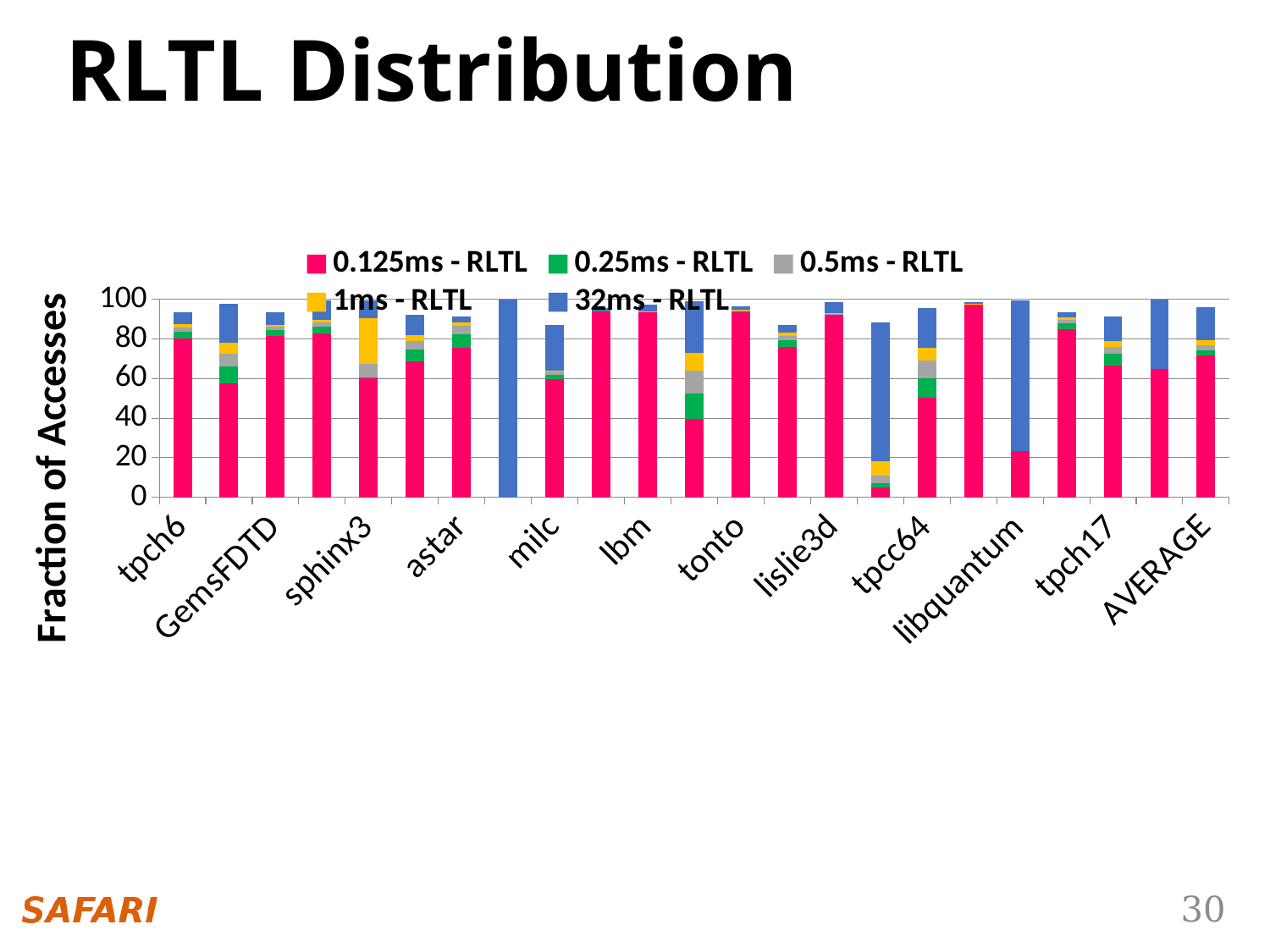
Is the 0.125ms - RLTL value for lbm greater or less than 80? greater Is the 0.125ms - RLTL value for AVERAGE greater or less than 60? greater Among the labelled categories on the x axis, which has the lowest 0.125ms - RLTL value? libquantum Which has the larger 0.125ms - RLTL value, tpch6 or tpcc64? tpch6 What is the title of the chart's vertical axis? Fraction of Accesses Is the 0.125ms - RLTL value for tpcc64 greater or less than 80? less Which colour represents the 32ms - RLTL series in the legend? blue Which has the larger 0.125ms - RLTL value, lbm or libquantum? lbm How many series does the legend list? 5 What kind of chart is shown on the slide? bar chart